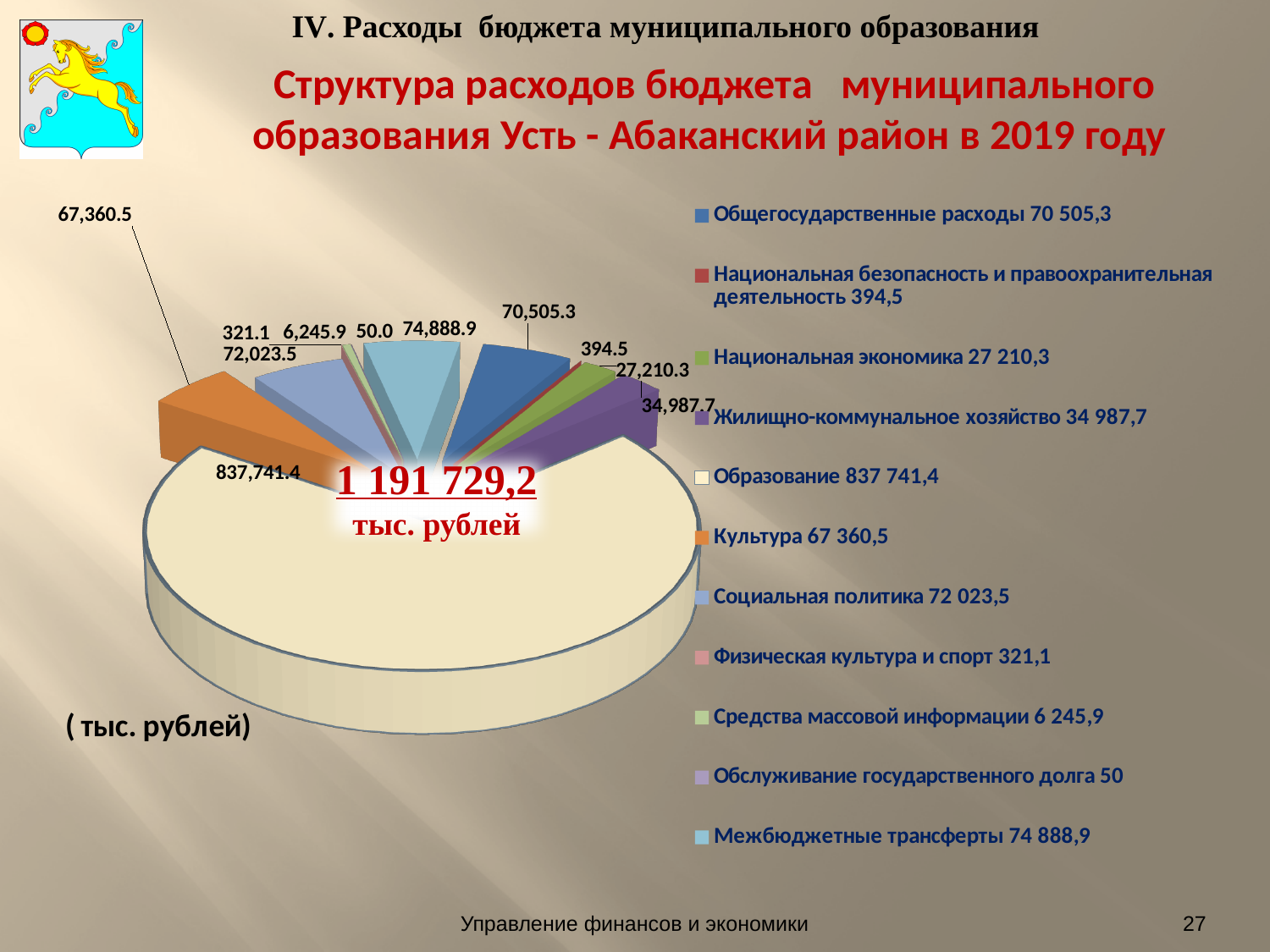
What total amount is printed in the centre of the pie chart? 1 191 729,2 тыс. рублей How many categories does the legend list? 11 What is the value for Национальная безопасность и правоохранительная деятельность? 394.5 What type of chart is shown on the slide? Pie chart What is the difference between Межбюджетные трансферты and Социальная политика? 2,865.4 Which is larger, Национальная экономика or Жилищно-коммунальное хозяйство? Жилищно-коммунальное хозяйство What is the difference between Общегосударственные расходы and Культура? 3,144.8 What is the value for Жилищно-коммунальное хозяйство? 34,987.7 Which category has the smallest value? Обслуживание государственного долга What is the value for Образование? 837,741.4 What is the value for Межбюджетные трансферты? 74,888.9 Which category has the largest slice of the pie? Образование